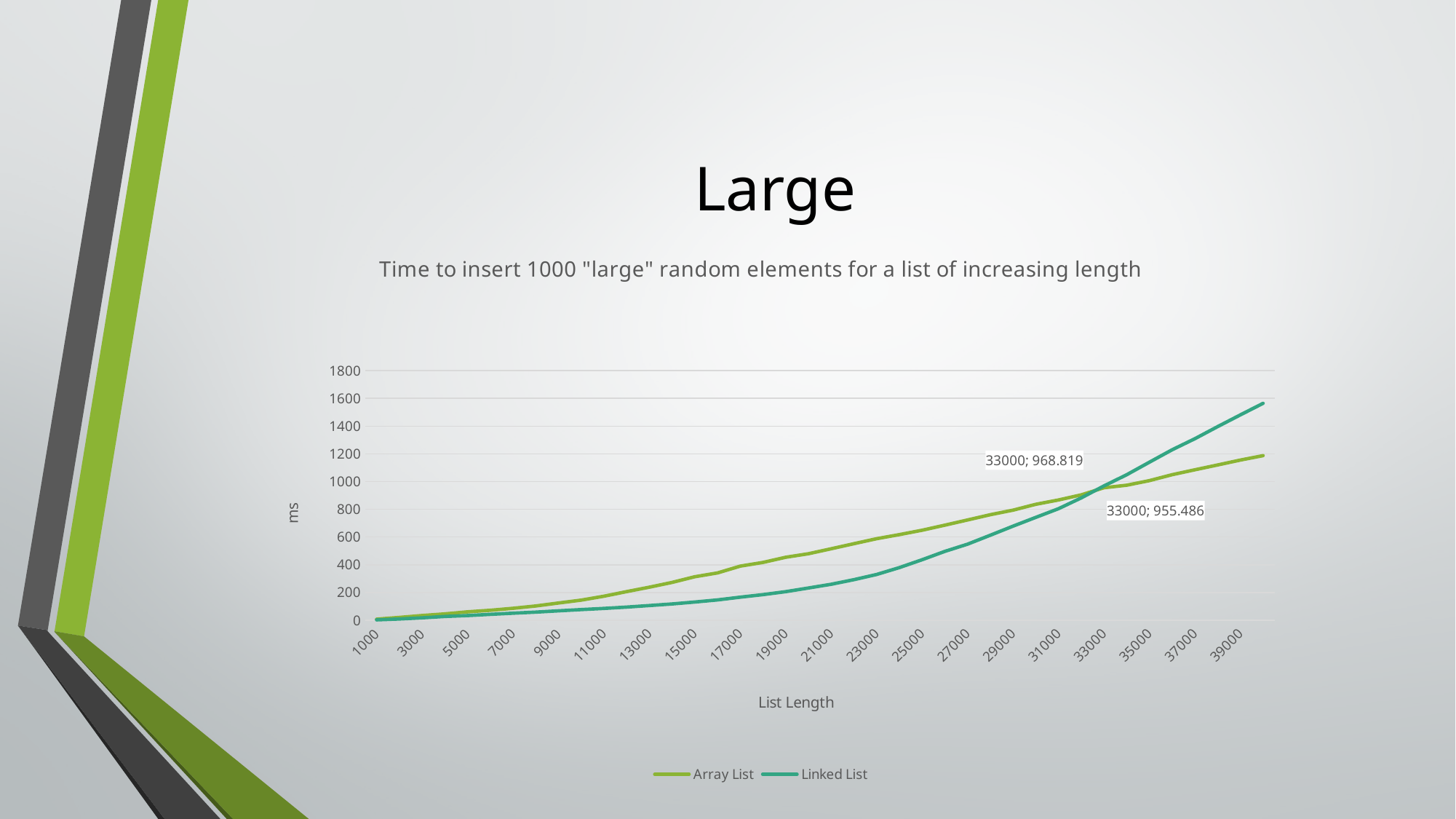
What is the title of the x axis? List Length Is the Array List value at list length 15000 greater or less than 400? less Is the Array List value at list length 39000 greater or less than 1400? less What are the names of the two series in the legend? Array List and Linked List Is the Linked List value at list length 27000 greater or less than 400? greater At list length 39000, which series has the higher value, Array List or Linked List? Linked List How many series does the legend list? 2 At list length 21000, which series has the higher value, Array List or Linked List? Array List What kind of chart is shown on the slide? line chart Do the Linked List values rise or fall as list length increases? rise What is the difference between the two labelled values at list length 33000? 13.333